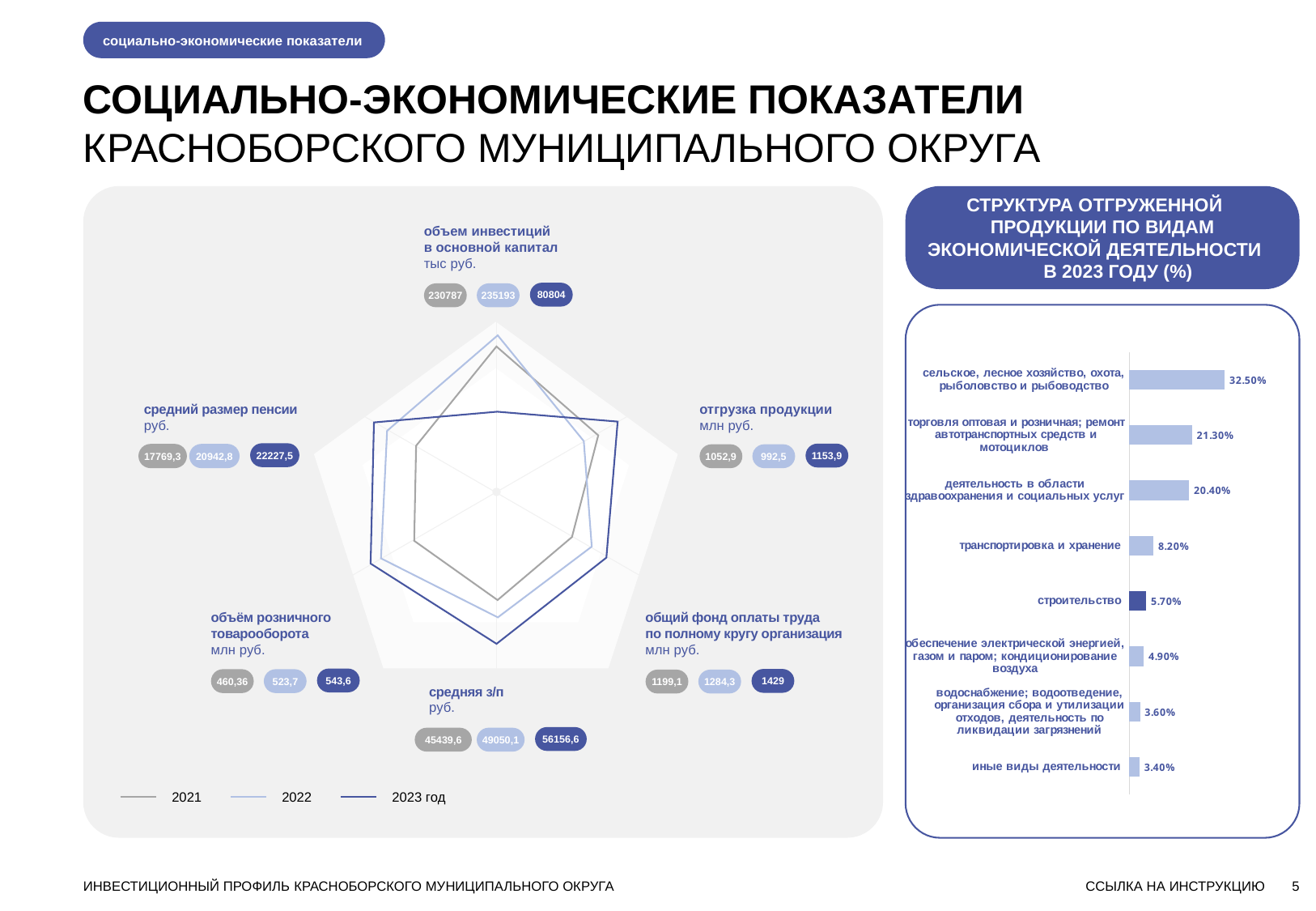
On the bar chart on the right, what is the difference between торговля оптовая и розничная; ремонт автотранспортных средств и мотоциклов and деятельность в области здравоохранения и социальных услуг? 0.90% On the radar chart on the left, how many indicators (axes) are shown? 6 On the bar chart on the right, what is the value for строительство? 5.70% On the radar chart on the left, what is the value of отгрузка продукции for 2022? 992,5 What kind of chart is the chart on the right of the slide? bar chart On the bar chart on the right, which category has the highest value? сельское, лесное хозяйство, охота, рыболовство и рыбоводство On the bar chart on the right, which category has the lowest value? иные виды деятельности On the bar chart on the right, how many categories are shown? 8 On the radar chart on the left, how many series does the legend list? 3 On the bar chart on the right, what is the value for сельское, лесное хозяйство, охота, рыболовство и рыбоводство? 32.50% On the radar chart on the left, what is the value of средняя з/п for 2023? 56156,6 On the bar chart on the right, which is larger: транспортировка и хранение or обеспечение электрической энергией, газом и паром; кондиционирование воздуха? транспортировка и хранение